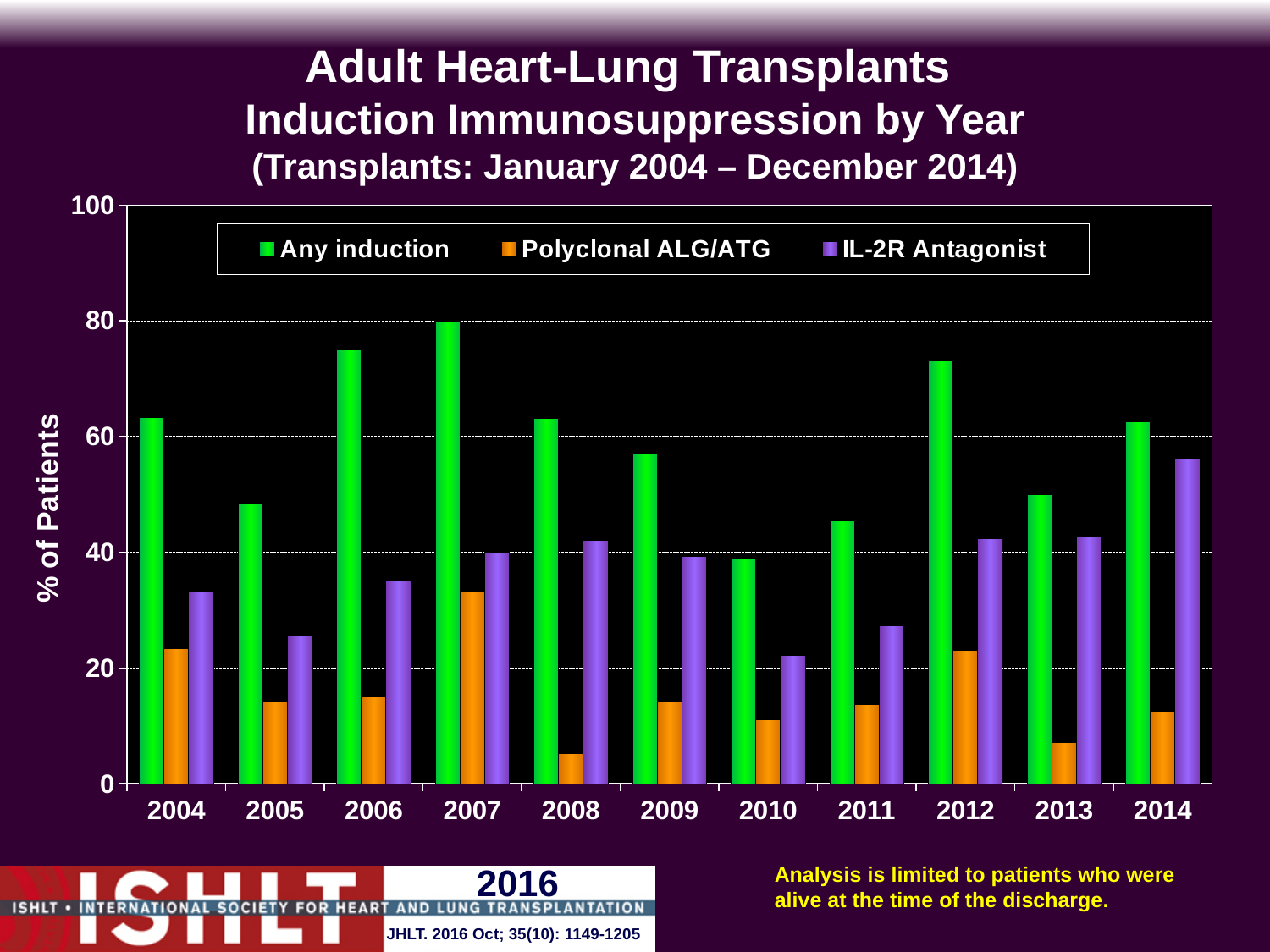
Is the Any induction value for 2007 greater or less than 60? greater In 2014, which is larger: the IL-2R Antagonist value or the Polyclonal ALG/ATG value? IL-2R Antagonist In which year is the Any induction value lowest? 2010 What is the label of the y axis? % of Patients In which year is the Polyclonal ALG/ATG value highest? 2007 What kind of chart is shown on the slide? bar chart In which year is the Any induction value highest? 2007 Is the IL-2R Antagonist value for 2014 greater or less than 40? greater How many years are shown on the x axis? 11 In which year is the IL-2R Antagonist value highest? 2014 How many series does the legend list? 3 Is the Polyclonal ALG/ATG value for 2008 greater or less than 20? less